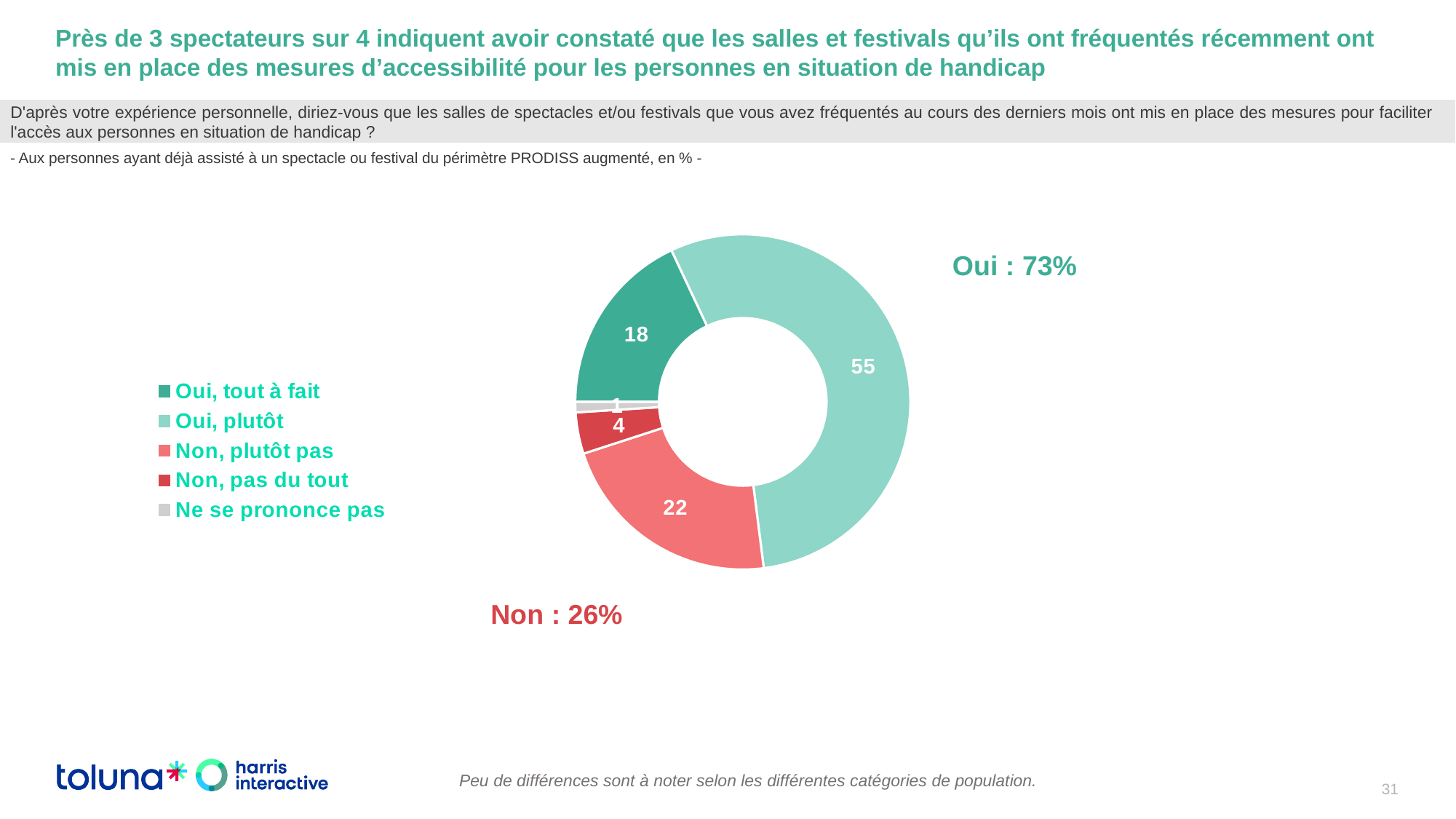
What value is shown for "Oui, tout à fait"? 18 How many categories does the legend list? 5 Which category has the largest slice? Oui, plutôt What value is shown for "Oui, plutôt"? 55 Which category has the smallest slice? Ne se prononce pas What value is shown for "Non, pas du tout"? 4 Which is larger, the value for "Oui, tout à fait" or the value for "Non, plutôt pas"? Non, plutôt pas What kind of chart is shown on the slide? Pie chart (donut) What is the difference between the values for "Oui, plutôt" and "Non, plutôt pas"? 33 What total percentage is shown for "Oui" next to the chart? 73% What value is shown for "Non, plutôt pas"? 22 What total percentage is shown for "Non" next to the chart? 26%